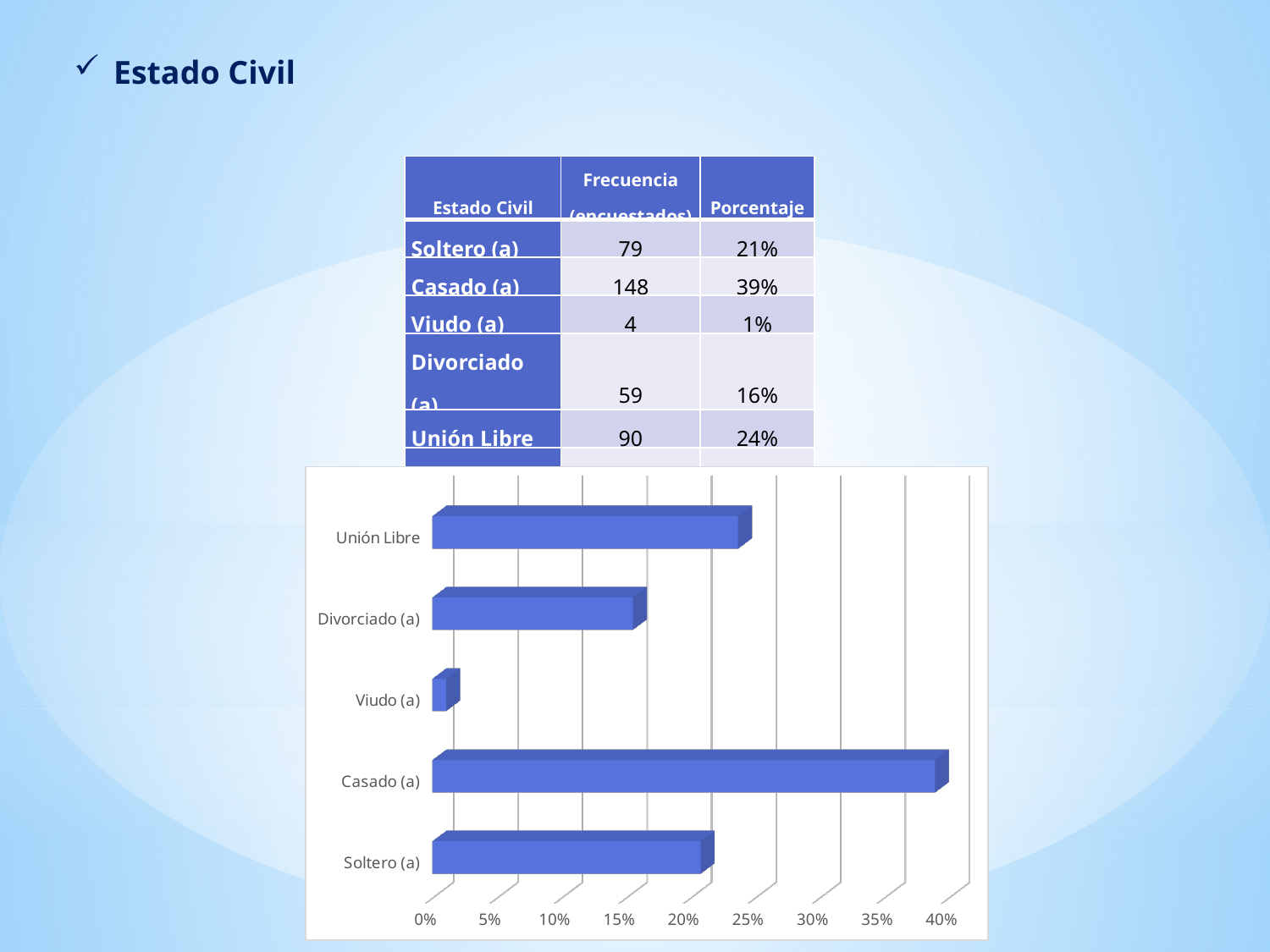
Which category has the longest bar in the chart? Casado (a) Is the value for Divorciado (a) greater or less than 20%? less Is the value for Casado (a) greater or less than 35%? greater Which is larger, the value for Divorciado (a) or the value for Soltero (a)? Soltero (a) What kind of chart is shown on the slide? bar chart Is the value for Unión Libre greater or less than 20%? greater Which category has the shortest bar in the chart? Viudo (a) According to the table on the slide, what percentage corresponds to Casado (a)? 39% What is the highest value shown on the chart's horizontal axis? 40% Which is larger, the value for Unión Libre or the value for Soltero (a)? Unión Libre How many categories does the bar chart show? 5